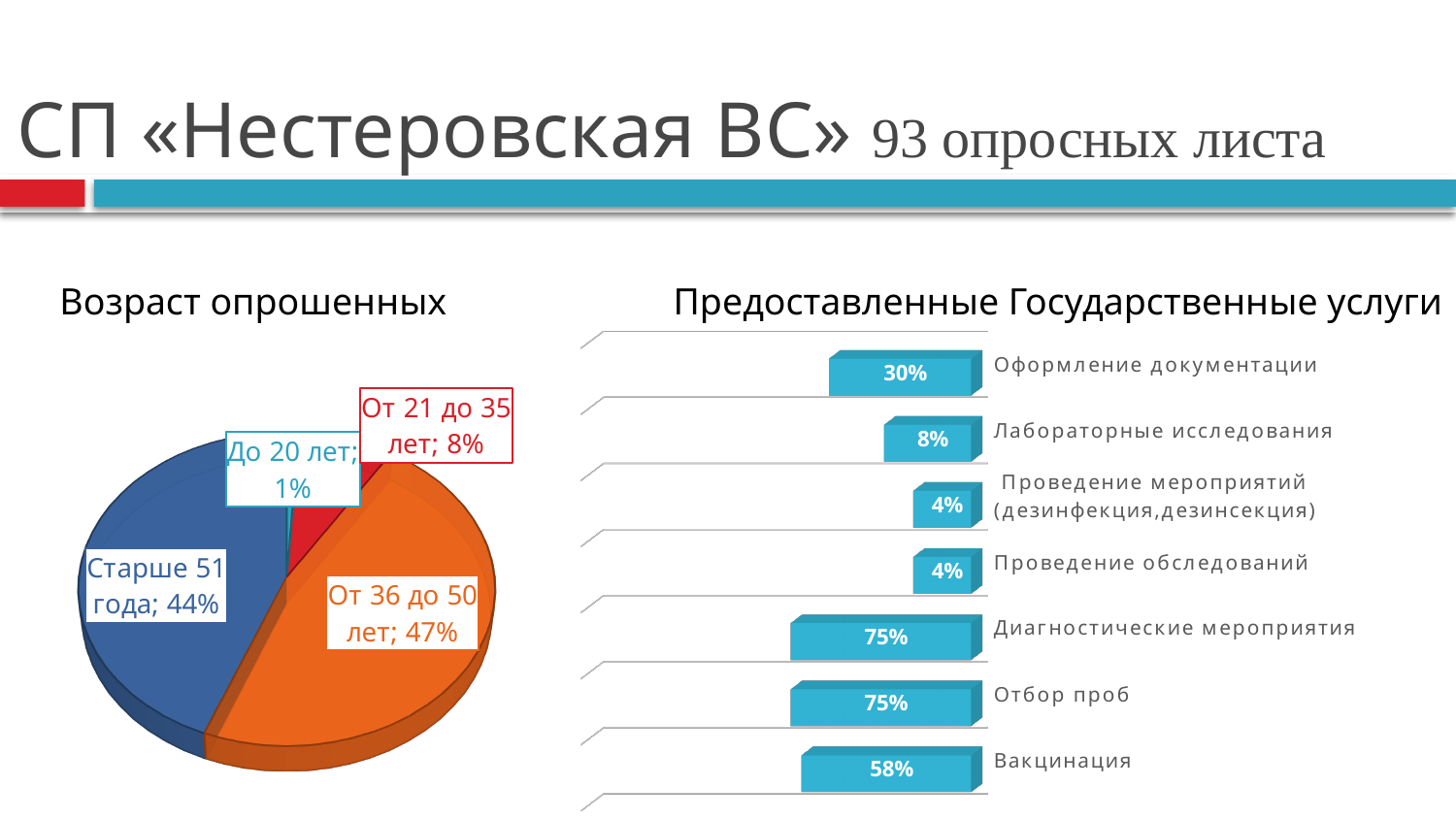
In the chart 'Предоставленные Государственные услуги', what is the value for 'Оформление документации'? 30% How many categories are shown in the chart 'Предоставленные Государственные услуги'? 7 In the chart 'Предоставленные Государственные услуги', which services have the highest value? Диагностические мероприятия and Отбор проб In the chart 'Возраст опрошенных', what share of respondents are 'От 36 до 50 лет'? 47% In the chart 'Возраст опрошенных', which age group has the largest share? От 36 до 50 лет In the chart 'Возраст опрошенных', what is the difference between the shares of 'От 36 до 50 лет' and 'Старше 51 года'? 3% What kind of chart is 'Возраст опрошенных'? Pie chart How many slices does the pie chart 'Возраст опрошенных' have? 4 In the chart 'Предоставленные Государственные услуги', which is larger: 'Оформление документации' or 'Лабораторные исследования'? Оформление документации In the chart 'Возраст опрошенных', which age group has the smallest share? До 20 лет In the chart 'Предоставленные Государственные услуги', what is the difference between 'Отбор проб' and 'Вакцинация'? 17% In the chart 'Предоставленные Государственные услуги', what is the value for 'Вакцинация'? 58%